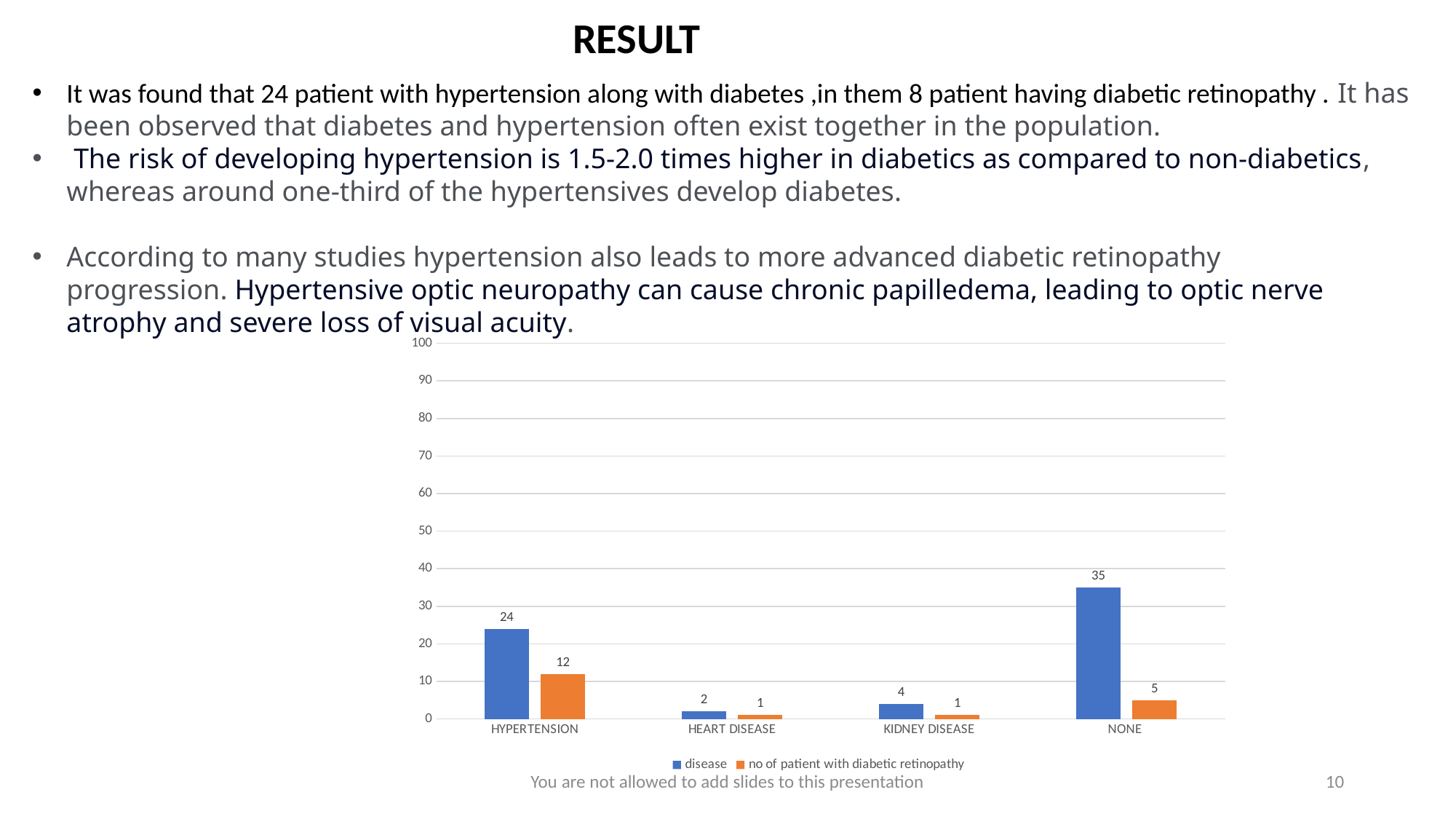
What is the value of 'no of patient with diabetic retinopathy' for HYPERTENSION? 12 How many categories are shown on the x axis? 4 Is the 'disease' value for NONE greater or less than 30? greater What is the value of 'no of patient with diabetic retinopathy' for NONE? 5 What is the value of the 'disease' series for HYPERTENSION? 24 Which category has the highest value in the 'disease' series? NONE What kind of chart is shown on the slide? bar chart What colour are the bars for the 'no of patient with diabetic retinopathy' series? orange How many series does the legend list? 2 Which category has the lowest value in the 'disease' series? HEART DISEASE Which is larger: the 'disease' value for KIDNEY DISEASE or the 'disease' value for HEART DISEASE? KIDNEY DISEASE What is the difference between the 'disease' value and the 'no of patient with diabetic retinopathy' value for HYPERTENSION? 12